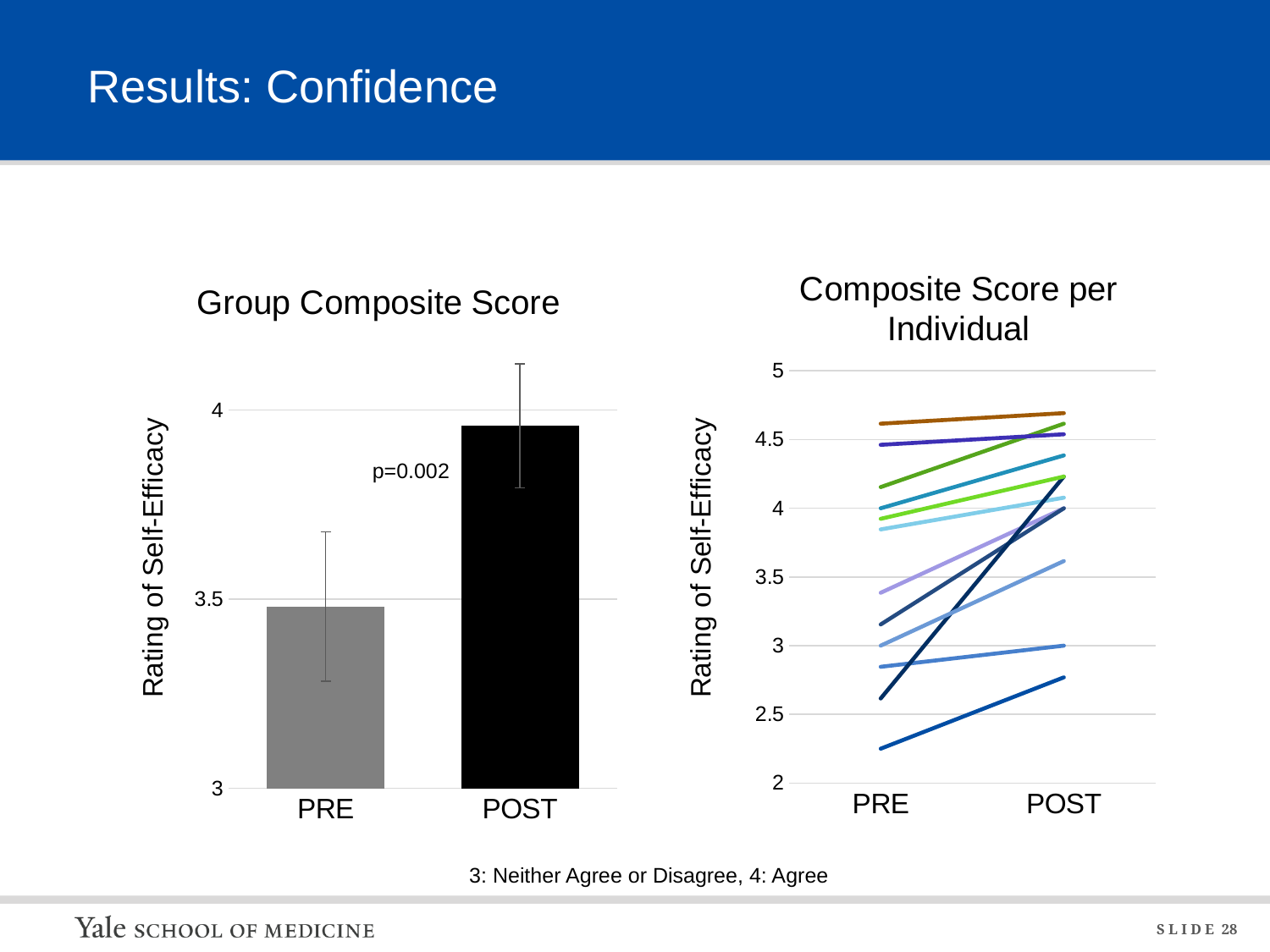
In the Composite Score per Individual chart, is the lowest individual's PRE value greater or less than 2.5? less What kind of chart is the Group Composite Score chart? bar chart In the Group Composite Score chart, is the value for PRE greater or less than 3? greater In the Group Composite Score chart, which category has the lowest value? PRE What p-value is printed on the Group Composite Score chart? p=0.002 In the Group Composite Score chart, which category has the higher bar, PRE or POST? POST In the Group Composite Score chart, is the value for POST greater or less than 3.5? greater In the Composite Score per Individual chart, do the individual lines generally rise or fall from PRE to POST? rise What is the y-axis label of the Composite Score per Individual chart? Rating of Self-Efficacy What kind of chart is the Composite Score per Individual chart? line chart How many categories are shown on the x axis of the Group Composite Score chart? 2